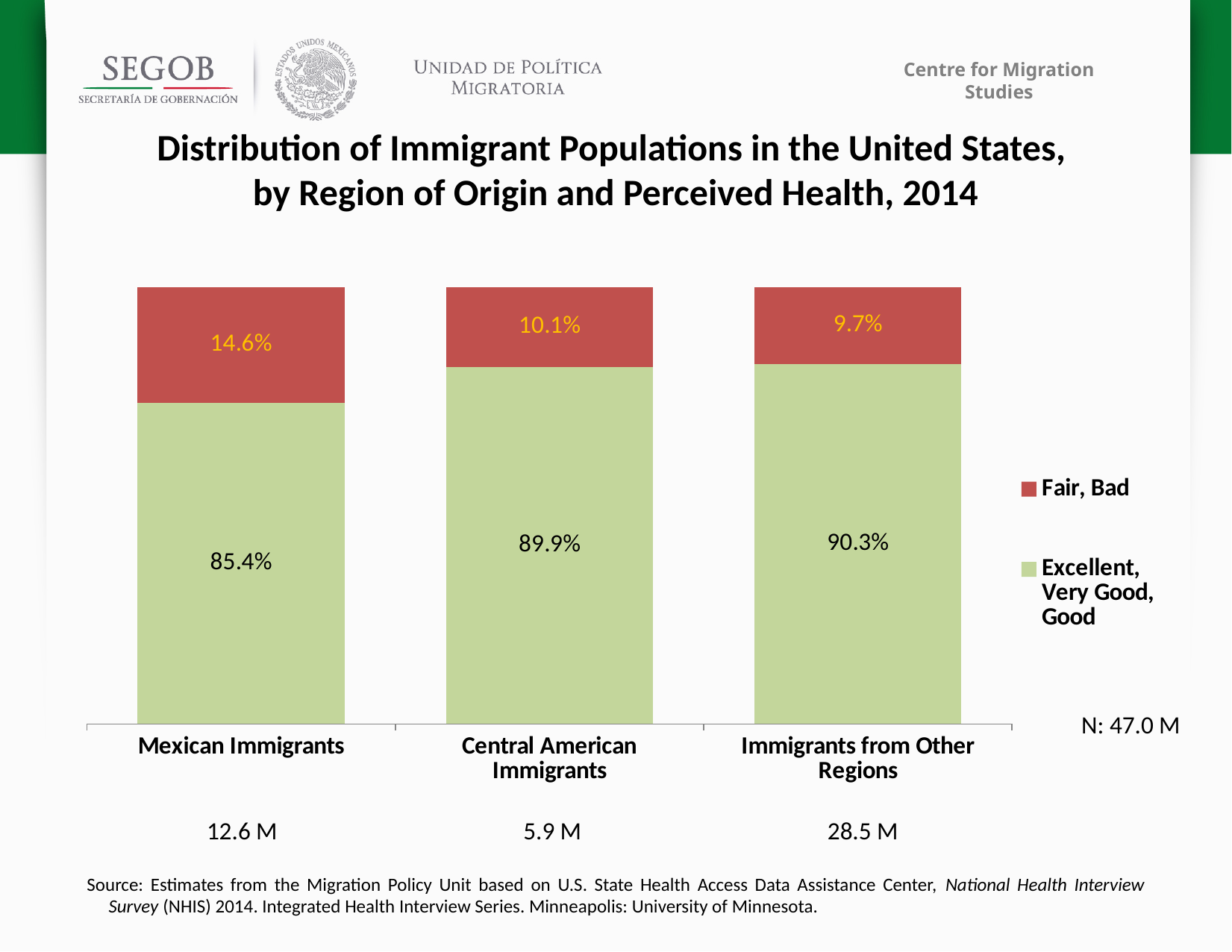
What kind of chart is shown on the slide? Stacked bar chart What percentage of Immigrants from Other Regions reported Excellent, Very Good, or Good health? 90.3% What percentage of Mexican Immigrants reported Fair or Bad health? 14.6% What percentage of Central American Immigrants reported Fair or Bad health? 10.1% Which region of origin has the highest share reporting Fair or Bad health? Mexican Immigrants What is the difference in percentage points between the Fair, Bad share for Mexican Immigrants and for Central American Immigrants? 4.5 Which region of origin has the lowest share reporting Fair or Bad health? Immigrants from Other Regions What percentage of Mexican Immigrants reported Excellent, Very Good, or Good health? 85.4% What population size is shown below the Central American Immigrants bar? 5.9 M How many series does the legend list? 2 How many region-of-origin categories are shown on the x axis? 3 Which is larger: the Excellent, Very Good, Good share for Central American Immigrants or for Mexican Immigrants? Central American Immigrants